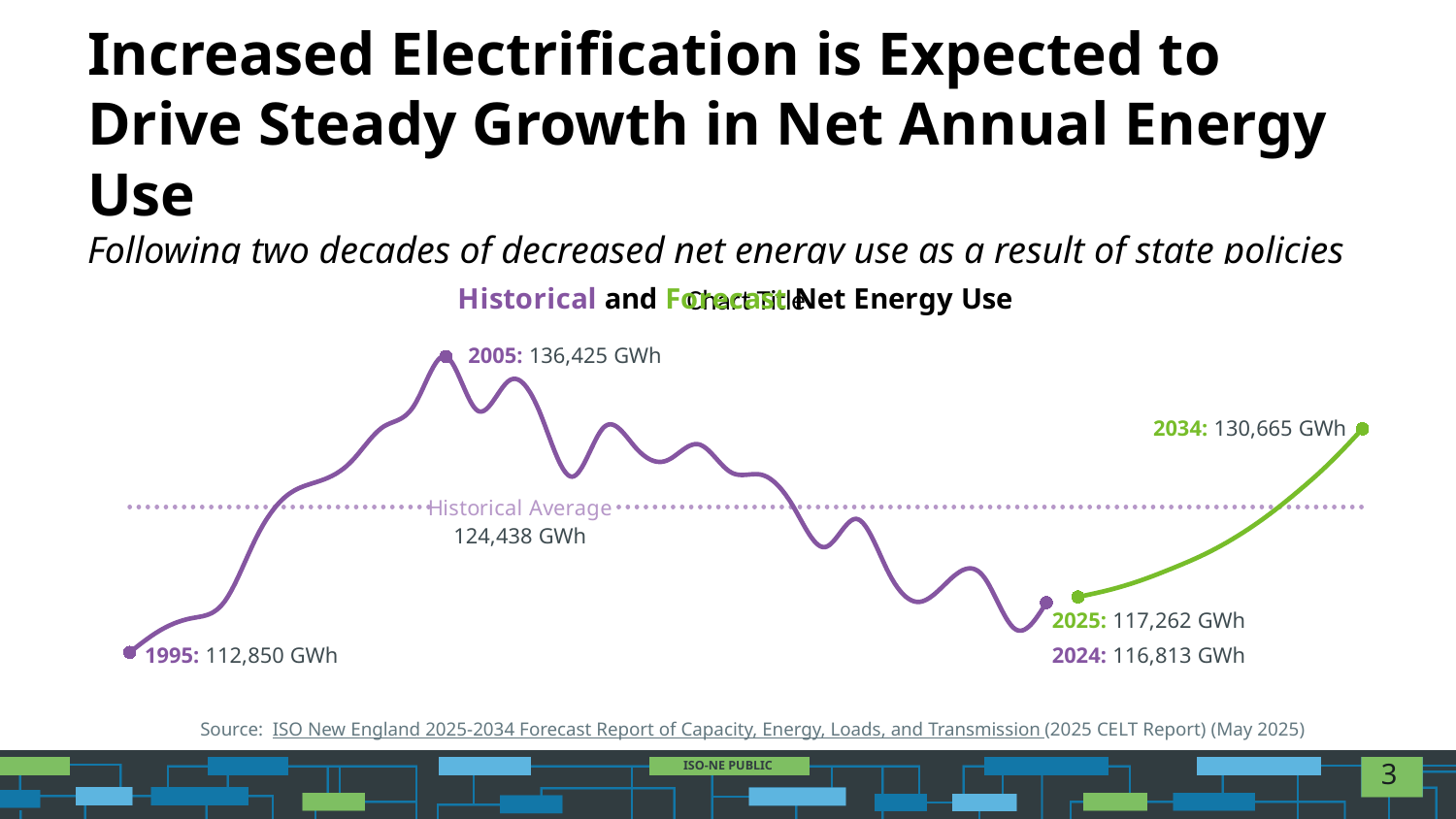
What value is given for the Historical Average line? 124,438 GWh What is the forecast net energy use value labelled for 2025? 117,262 GWh What is the difference between the 2034 forecast value and the 2025 forecast value? 13,403 GWh Which labelled year has the lowest net energy use value on the chart? 1995 What is the forecast net energy use value labelled for 2034? 130,665 GWh What is the net energy use value labelled for 2005? 136,425 GWh What is the difference between the 2005 value and the 1995 value? 23,575 GWh Which is larger, the 2034 forecast value or the 2005 historical value? 2005 What type of chart is shown on the slide? Line chart What is the net energy use value labelled for 1995? 112,850 GWh What is the net energy use value labelled for 2024? 116,813 GWh Which labelled year has the highest net energy use value on the chart? 2005